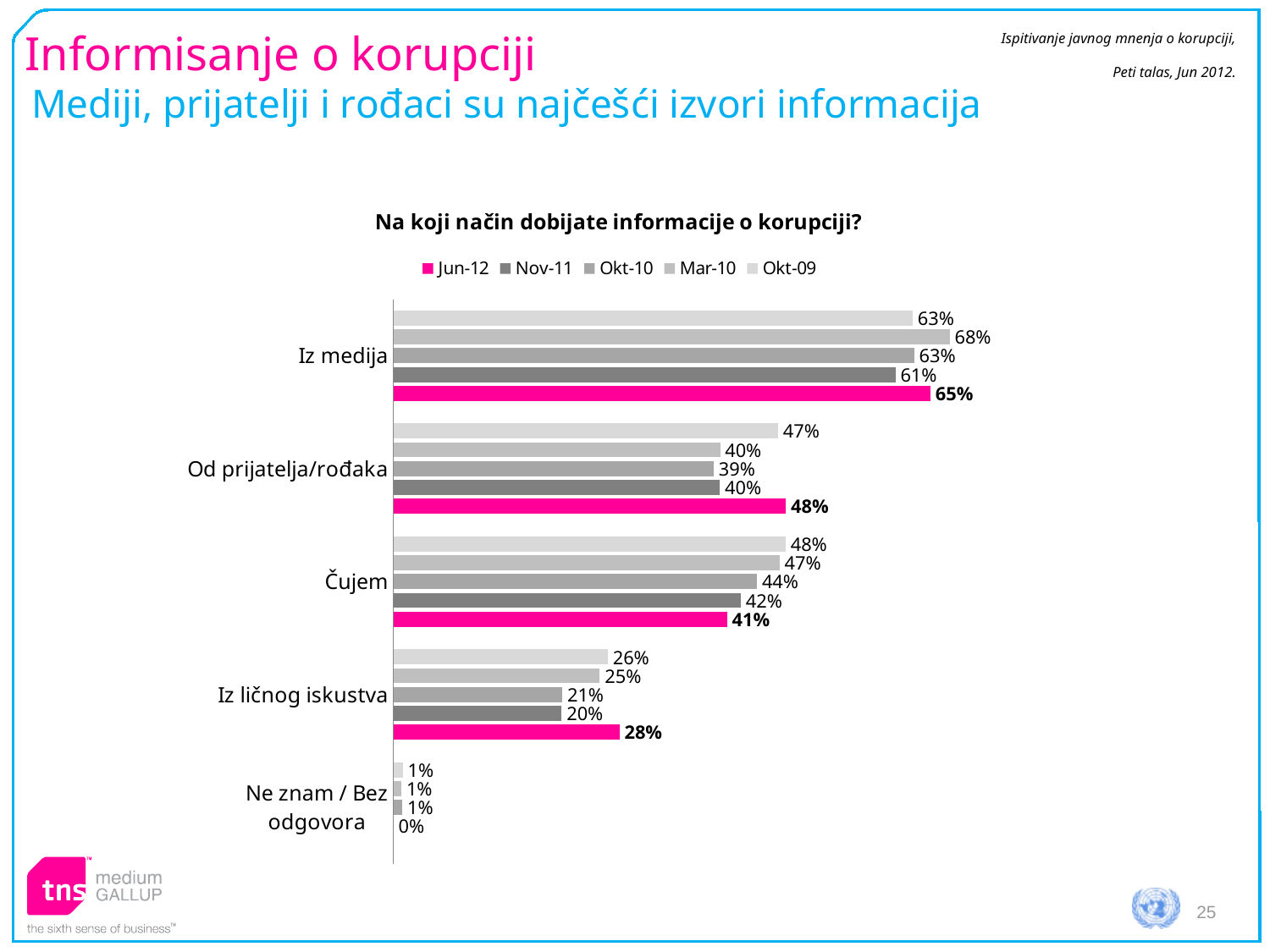
Which category has the highest Jun-12 value? Iz medija Which category has the lowest Okt-09 value? Ne znam / Bez odgovora How many series does the legend list? 5 For "Čujem", do the values rise or fall from Okt-09 to Jun-12? Fall How many categories are shown on the chart? 5 What is the difference between the Jun-12 values for "Iz medija" and "Od prijatelja/rođaka"? 17 percentage points What kind of chart is shown on the slide? Bar chart For "Iz medija", which is larger: the Mar-10 value or the Jun-12 value? Mar-10 For "Iz ličnog iskustva", which is larger: the Jun-12 value or the Nov-11 value? Jun-12 What is the Okt-09 value for "Od prijatelja/rođaka"? 47% What is the Nov-11 value for "Čujem"? 42% What is the Jun-12 value for "Iz medija"? 65%